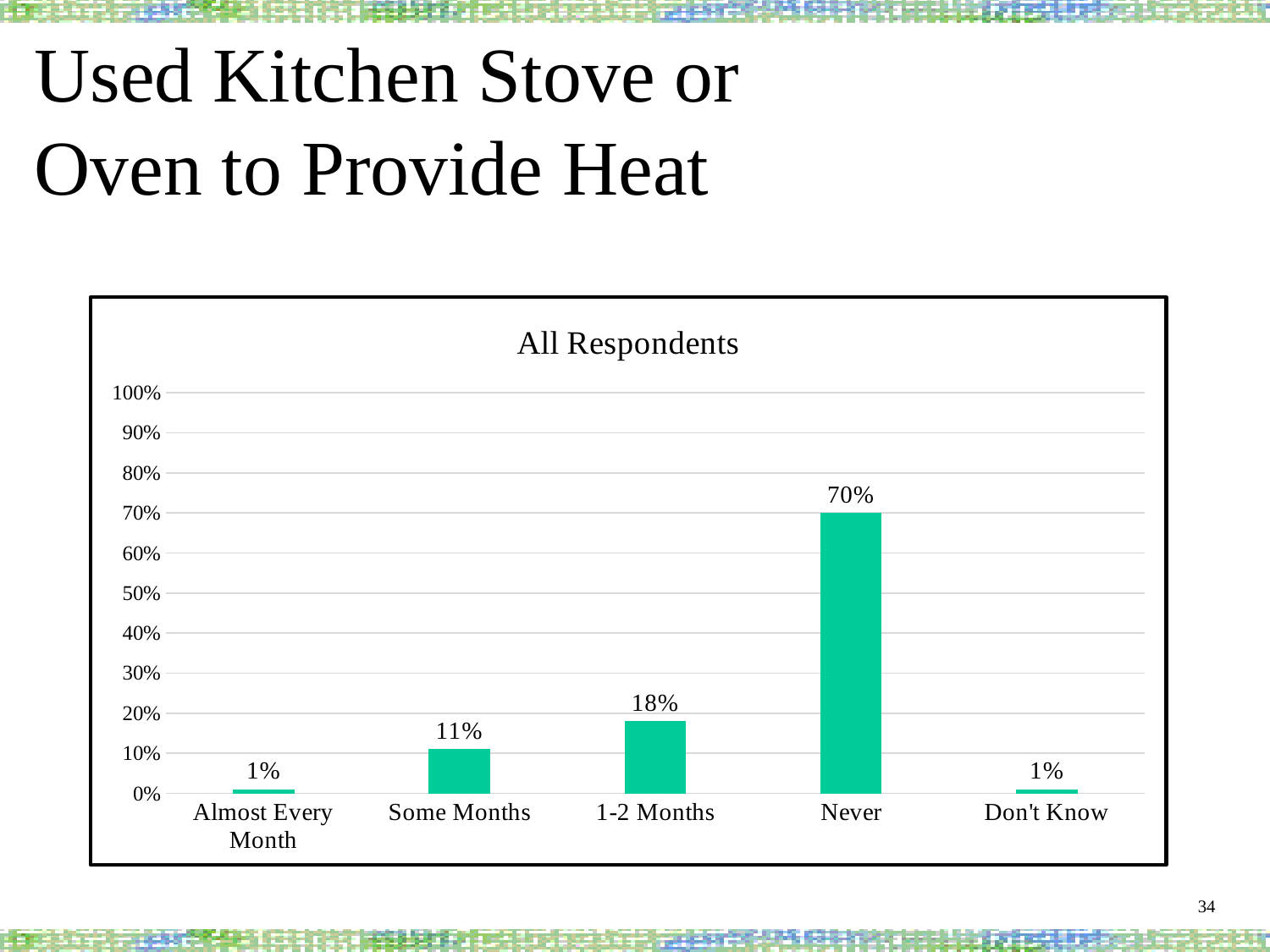
Which category has the highest value? Never Which is larger, the value for "Some Months" or the value for "1-2 Months"? 1-2 Months What is the difference between the values for "Never" and "1-2 Months"? 52% What is the value for "Almost Every Month"? 1% What is the value for "1-2 Months"? 18% What is the title of the chart? All Respondents What percentage of respondents answered "Never"? 70% Is the value for "Never" greater or less than 60%? greater What kind of chart is shown on the slide? Bar chart How many categories are shown on the x axis? 5 What is the value for "Some Months"? 11% What is the difference between the values for "1-2 Months" and "Some Months"? 7%